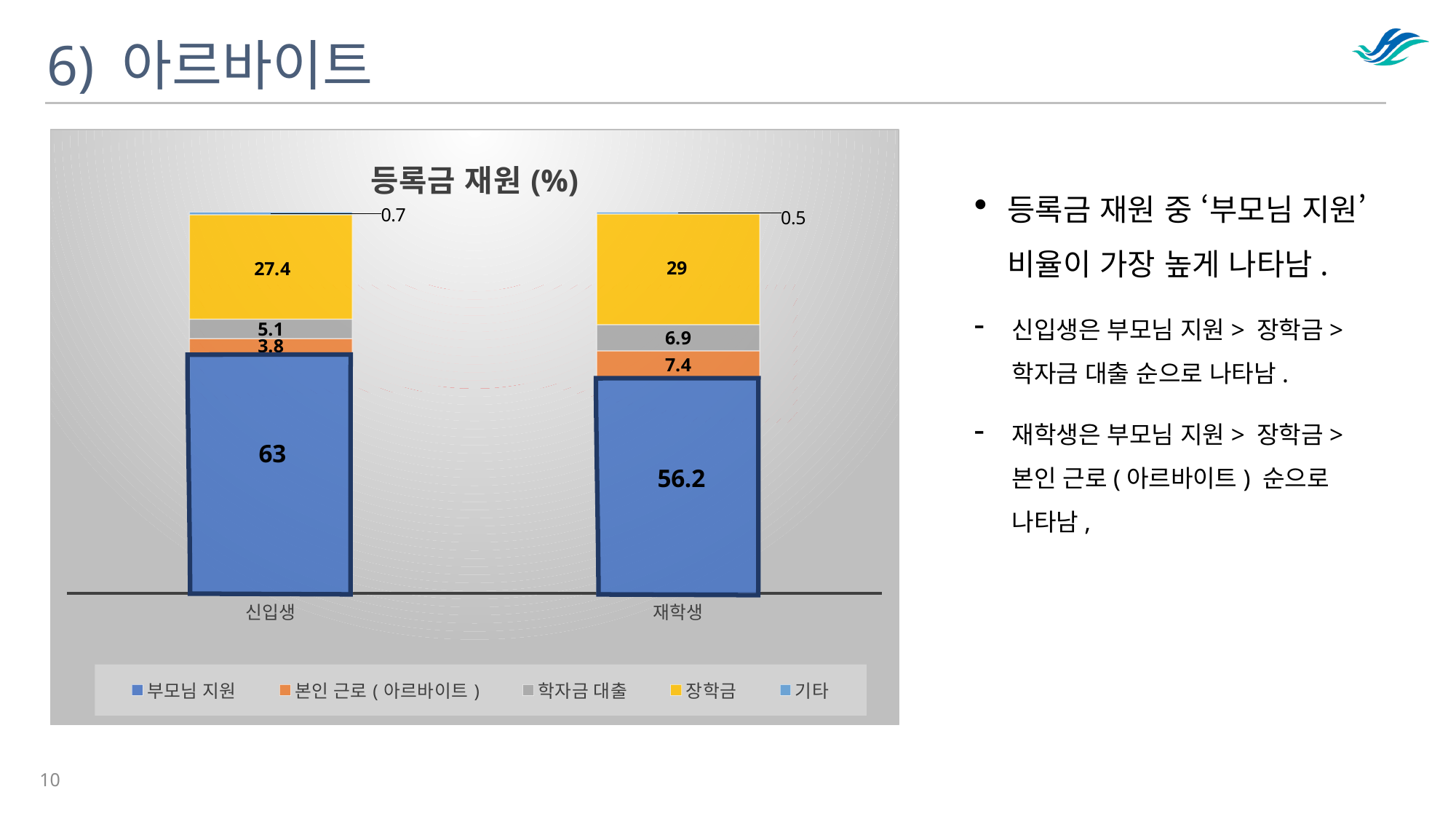
Which series has the lowest value for 재학생? 기타 What is the value of 본인 근로 (아르바이트) for 신입생? 3.8 What type of chart is shown on the slide? Stacked bar chart What is the title of the chart? 등록금 재원 (%) Which series has the highest value for 신입생? 부모님 지원 What is the value of 기타 for 재학생? 0.5 What is the difference between the 부모님 지원 values for 신입생 and 재학생? 6.8 What is the value of 부모님 지원 for 재학생? 56.2 How many series does the legend list? 5 What is the value of 부모님 지원 for 신입생? 63 Which category has the larger value for 학자금 대출, 신입생 or 재학생? 재학생 What is the value of 장학금 for 재학생? 29